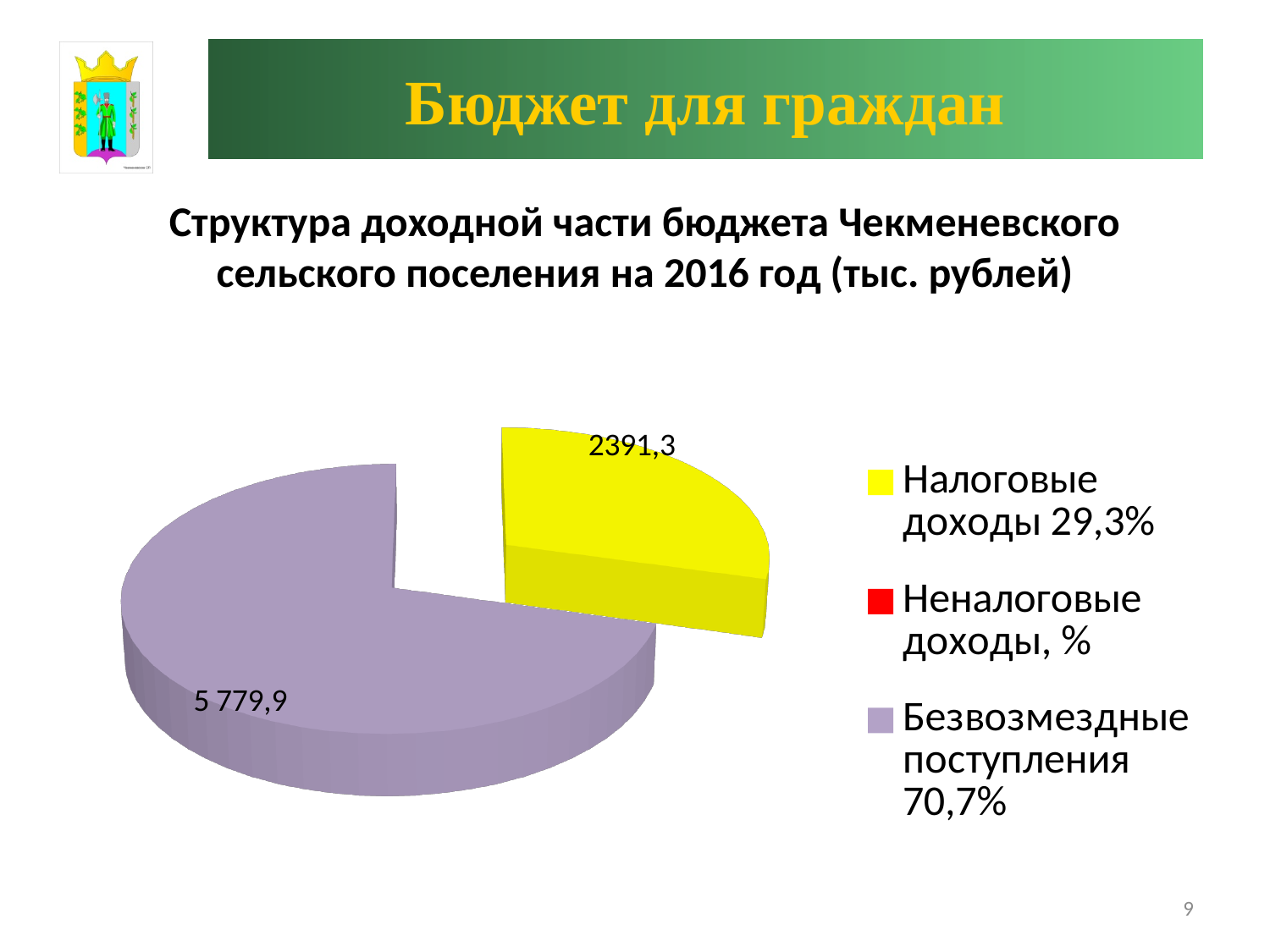
What is the value shown for Безвозмездные поступления? 5 779,9 What colour is the slice for Налоговые доходы? Yellow What is the total of the two labelled slices? 8 171,2 What is the value shown for Налоговые доходы? 2391,3 Which is larger: Налоговые доходы or Безвозмездные поступления? Безвозмездные поступления What share of the pie do Налоговые доходы represent, according to the legend? 29,3% Which of the visible slices is the smallest? Налоговые доходы Which category has the largest slice of the pie? Безвозмездные поступления How many entries does the legend list? 3 What type of chart is shown on the slide? Pie chart What share of the pie do Безвозмездные поступления represent, according to the legend? 70,7% What is the difference between the values for Безвозмездные поступления and Налоговые доходы? 3 388,6